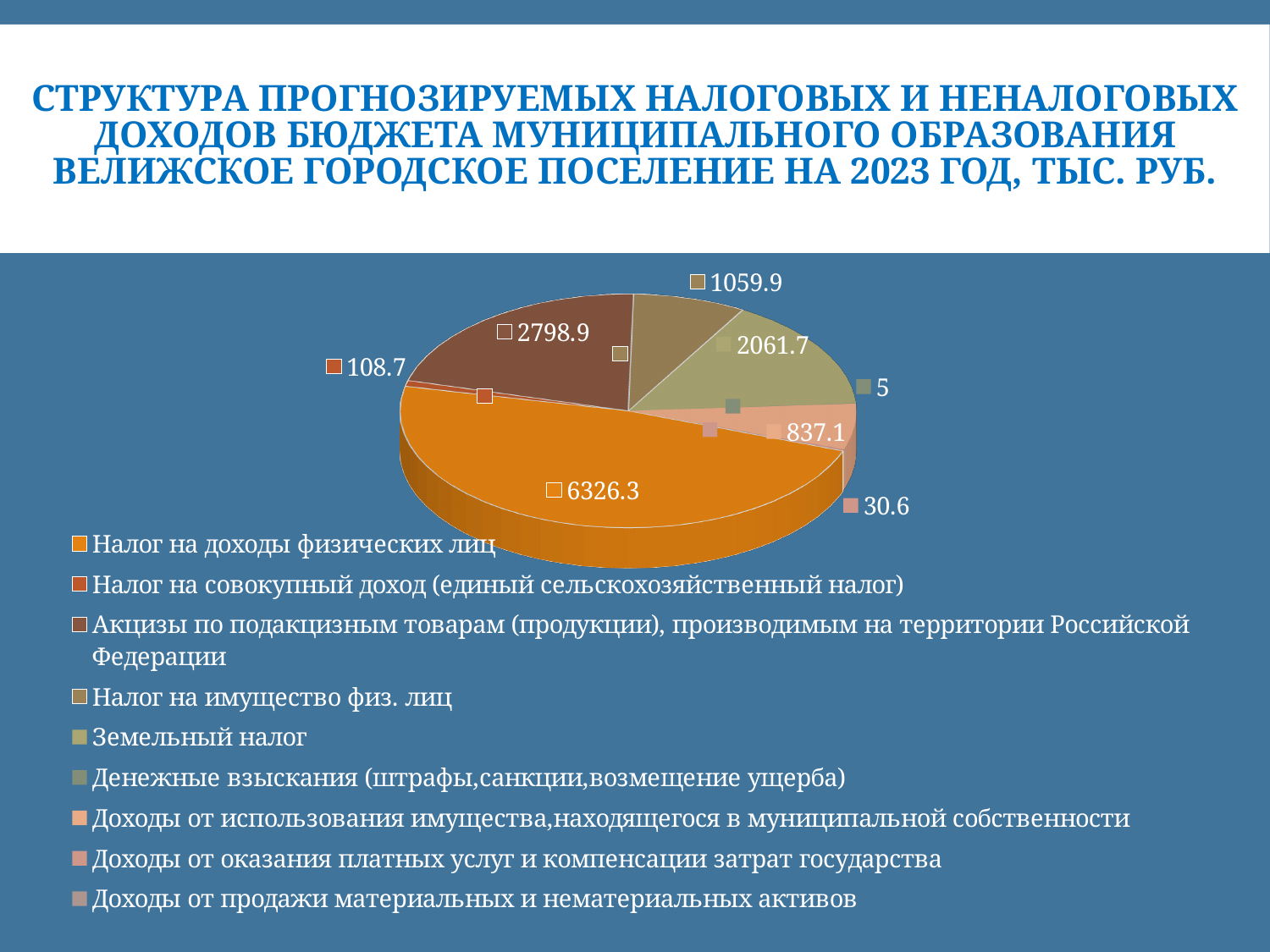
What is the value for Налог на совокупный доход (единый сельскохозяйственный налог)? 108.7 What is the value for Налог на доходы физических лиц? 6326.3 What is the value for Акцизы по подакцизным товарам (продукции), производимым на территории Российской Федерации? 2798.9 What unit of measurement is stated in the chart title? тыс. руб. What is the value for Земельный налог? 2061.7 Which is larger: Земельный налог or Налог на имущество физ. лиц? Земельный налог Which category has the largest slice of the pie? Налог на доходы физических лиц What is the smallest value labelled on the pie chart? 5 How many categories does the legend list? 9 What is the value for Налог на имущество физ. лиц? 1059.9 What is the difference between the values for Налог на доходы физических лиц and Акцизы по подакцизным товарам? 3527.4 What kind of chart is shown on the slide? pie chart